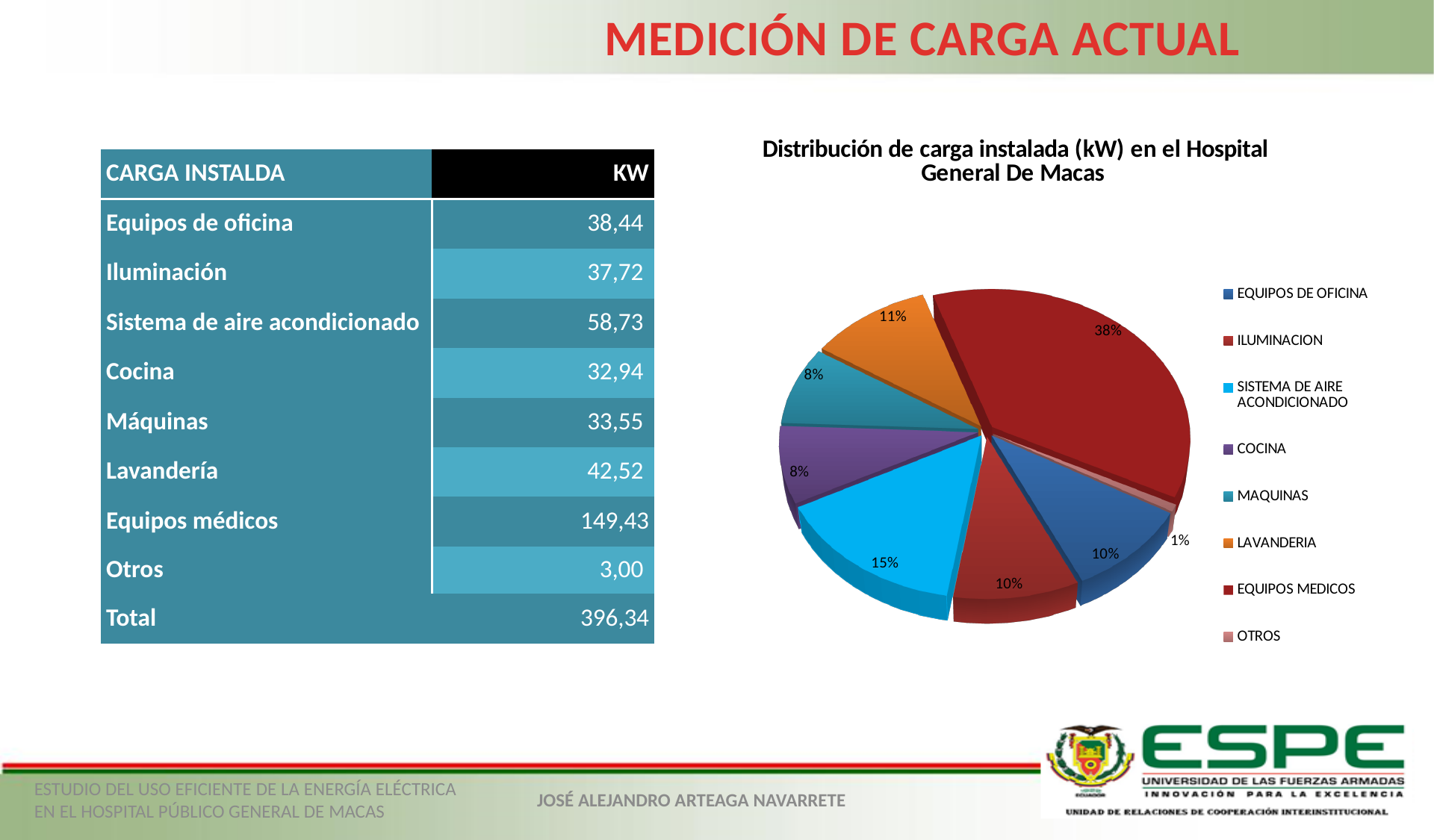
Which category has the largest slice of the pie chart? EQUIPOS MEDICOS What type of chart is shown on the slide? pie chart Which slice is larger in the pie chart, LAVANDERIA or MAQUINAS? LAVANDERIA What percentage is shown for OTROS in the pie chart? 1% What is the difference in percentage points between the EQUIPOS MEDICOS slice and the SISTEMA DE AIRE ACONDICIONADO slice? 23 What share of the pie does EQUIPOS MEDICOS represent? 38% How many entries does the pie chart's legend list? 8 How many slices does the pie chart have? 8 Which category has the smallest slice of the pie chart? OTROS What percentage is shown for LAVANDERIA in the pie chart? 11% What percentage is shown for SISTEMA DE AIRE ACONDICIONADO in the pie chart? 15% What is the title of the pie chart? Distribución de carga instalada (kW) en el Hospital General De Macas